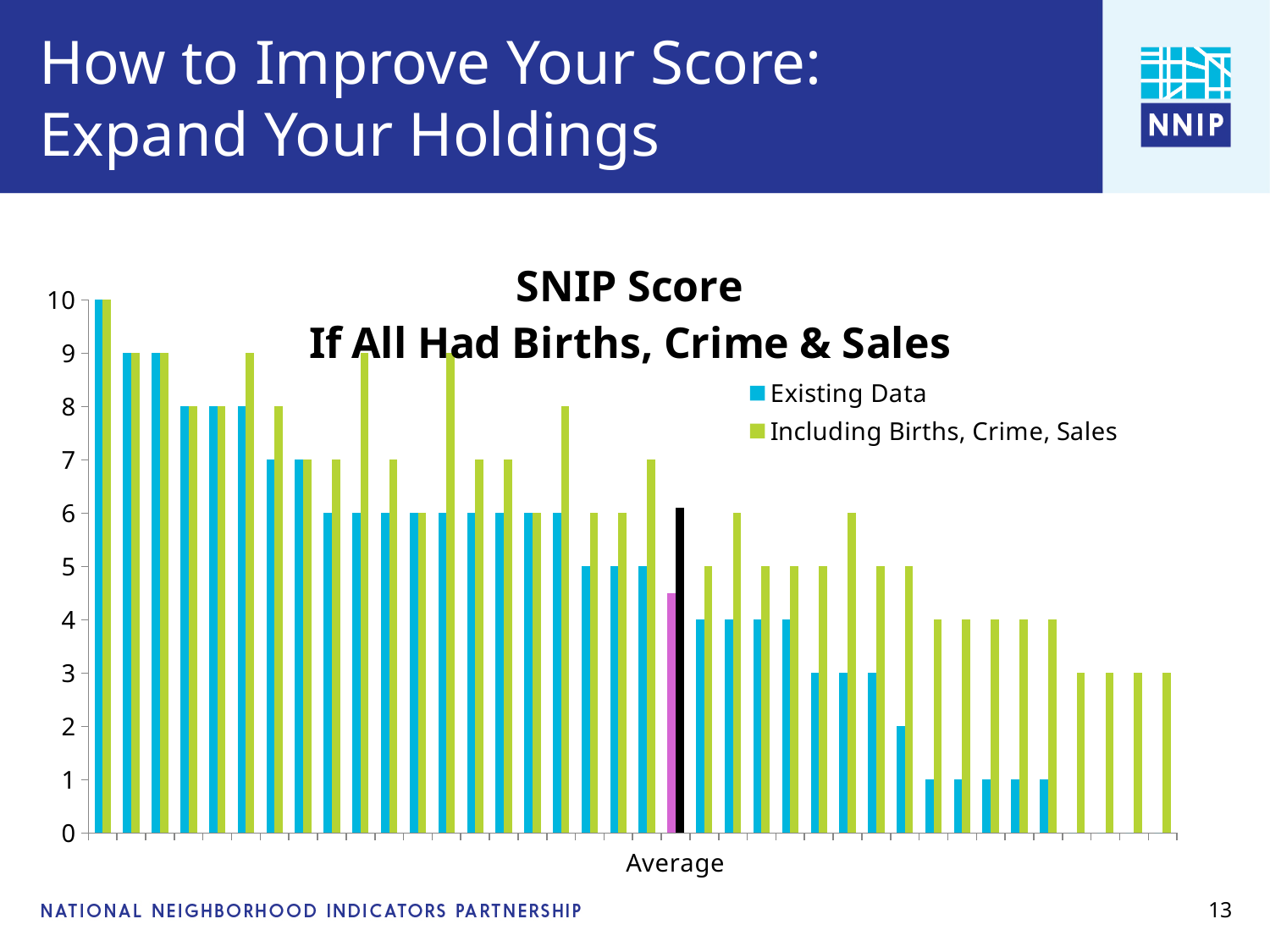
How many series does the legend list? 2 For the Average category, is the Including Births, Crime, Sales value greater or less than 7? less For the Average category, is the Existing Data value greater or less than 5? less For the Average category, is the Including Births, Crime, Sales value greater or less than 5? greater For the Average category, which series has the larger value, Existing Data or Including Births, Crime, Sales? Including Births, Crime, Sales What kind of chart is shown on the slide? bar chart Do the Existing Data values generally rise or fall from left to right along the x axis? fall What is the highest value shown on the y axis? 10 What are the two series named in the legend? Existing Data; Including Births, Crime, Sales What is the title of the chart? SNIP Score If All Had Births, Crime & Sales